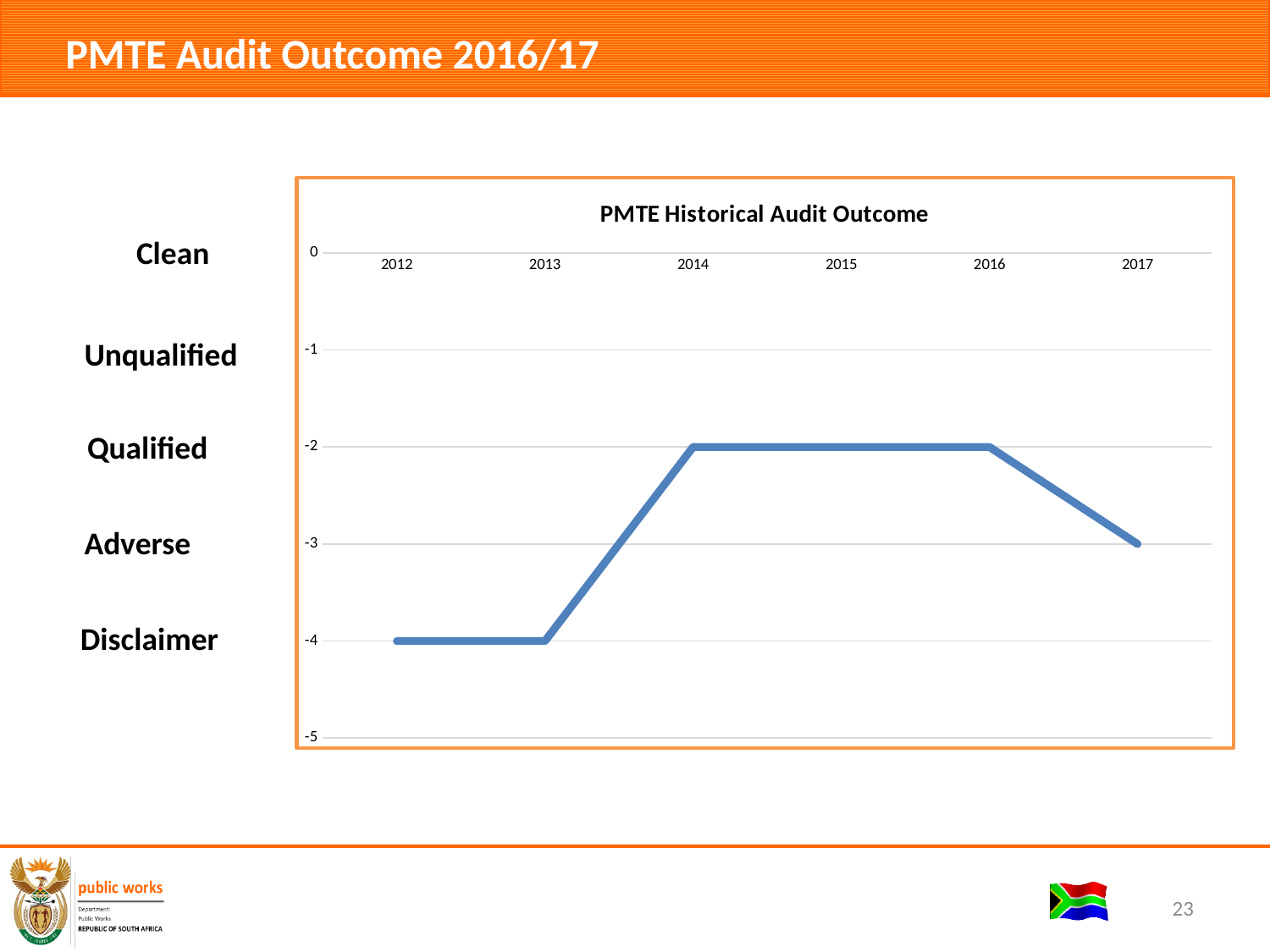
What value does the line show for 2012? -4 Does the line rise or fall between 2016 and 2017? fall How many years are plotted on the x axis of the chart? 6 Which audit outcome label on the left of the slide corresponds to the value plotted for 2017? Adverse Does the line rise or fall between 2013 and 2014? rise What value does the line show for 2017? -3 What value does the line show for 2013? -4 What is the title of the chart? PMTE Historical Audit Outcome Which year has the lowest value on the chart, 2012 or 2016? 2012 What value does the line show for 2014? -2 What is the difference between the values for 2014 and 2012? 2 What type of chart is shown on the slide? line chart